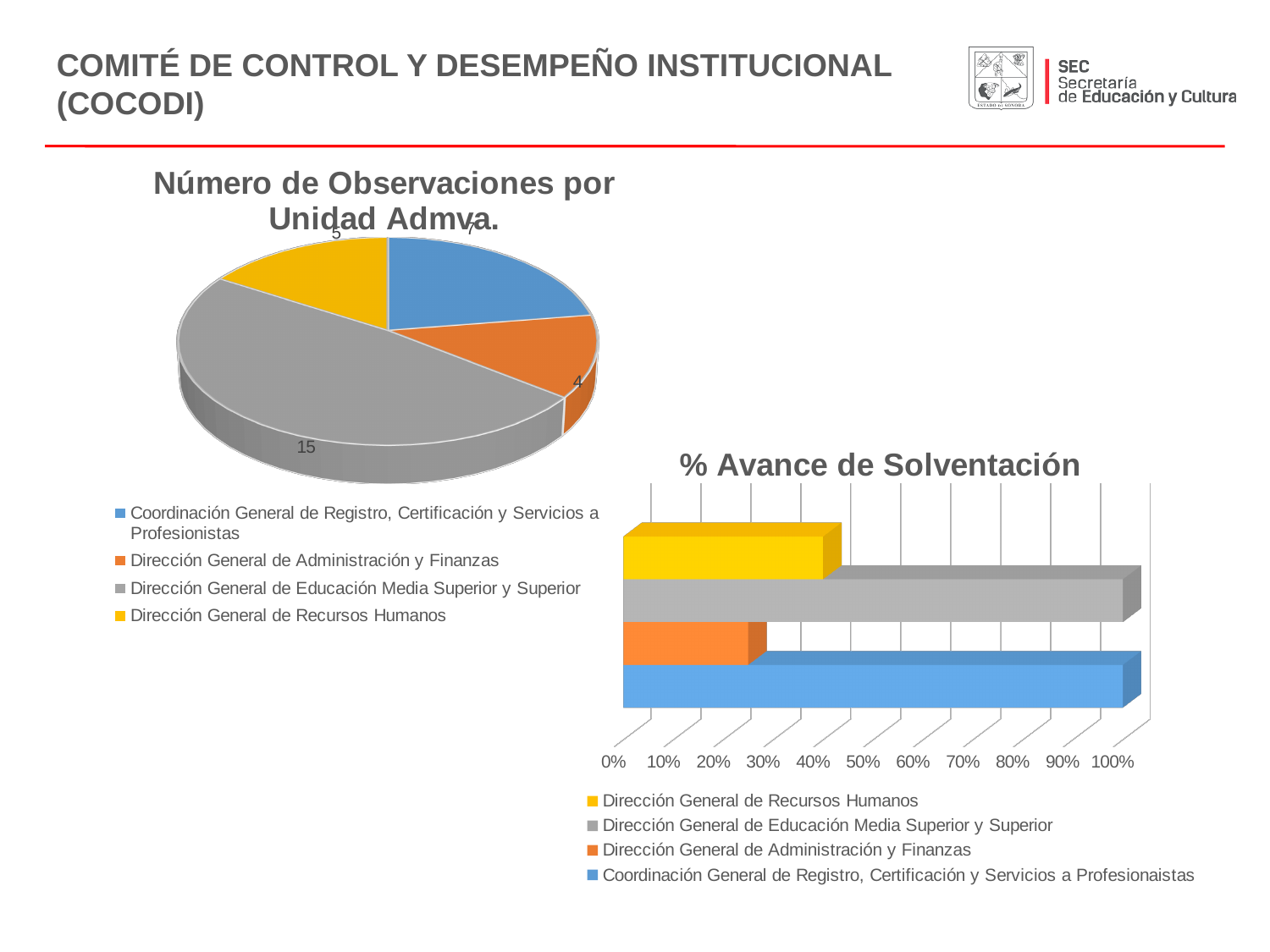
In the pie chart 'Número de Observaciones por Unidad Admva.', how many observations does Dirección General de Administración y Finanzas have? 4 In the pie chart 'Número de Observaciones por Unidad Admva.', how many observations does Dirección General de Educación Media Superior y Superior have? 15 In the pie chart 'Número de Observaciones por Unidad Admva.', which unit has the fewest observations? Dirección General de Administración y Finanzas In the pie chart 'Número de Observaciones por Unidad Admva.', what is the total number of observations across all units? 31 How many entries does the legend of the chart '% Avance de Solventación' list? 4 In the chart '% Avance de Solventación', is the value for Dirección General de Educación Media Superior y Superior greater or less than 90%? greater How many slices does the pie chart 'Número de Observaciones por Unidad Admva.' have? 4 In the pie chart 'Número de Observaciones por Unidad Admva.', what is the difference between the observations of Dirección General de Educación Media Superior y Superior and Coordinación General de Registro, Certificación y Servicios a Profesionistas? 8 What type of chart is '% Avance de Solventación'? Bar chart In the pie chart 'Número de Observaciones por Unidad Admva.', which has more observations: Dirección General de Recursos Humanos or Dirección General de Administración y Finanzas? Dirección General de Recursos Humanos In the pie chart 'Número de Observaciones por Unidad Admva.', which unit has the most observations? Dirección General de Educación Media Superior y Superior In the chart '% Avance de Solventación', is the value for Dirección General de Administración y Finanzas greater or less than 50%? less